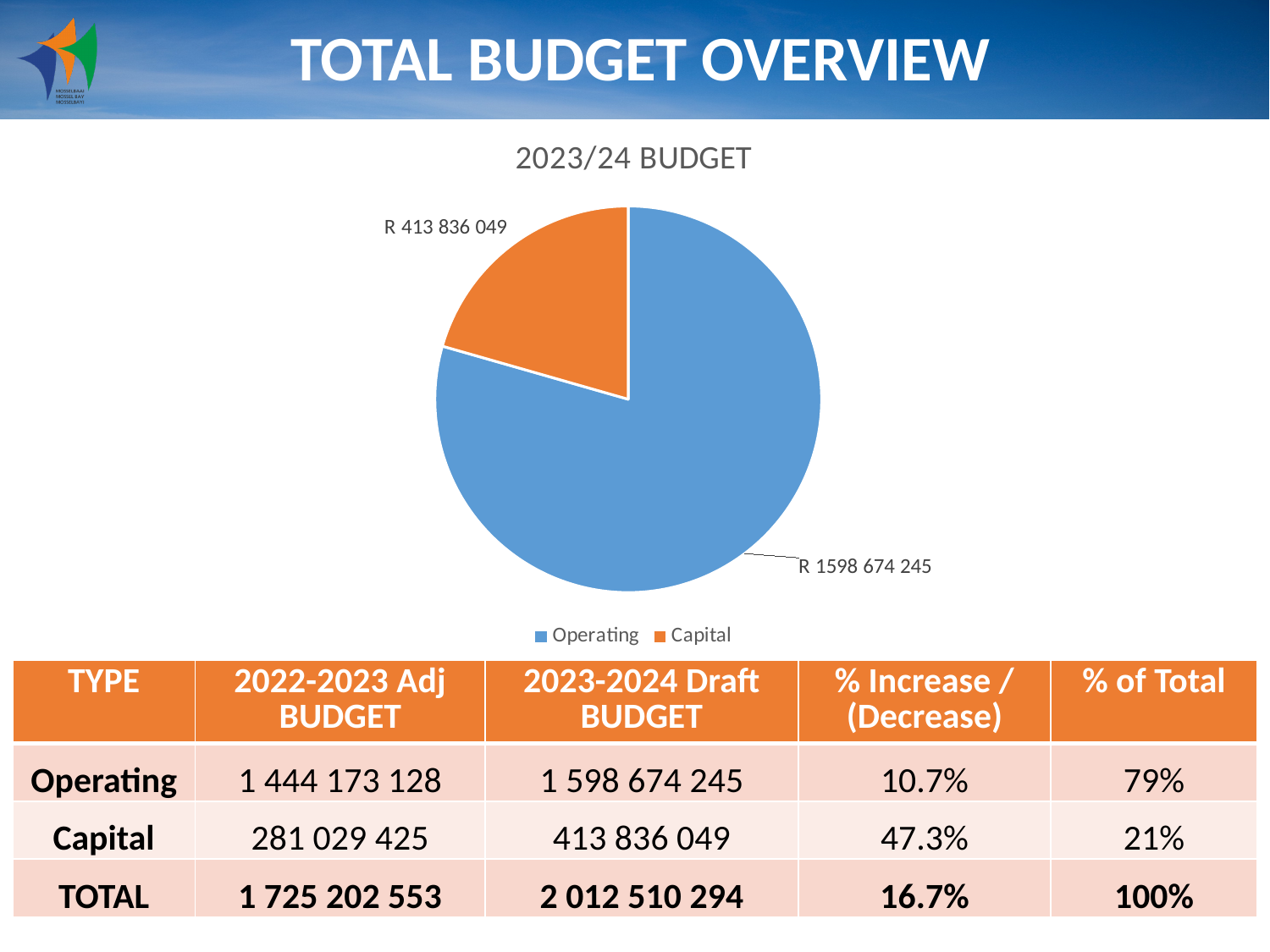
Which slice of the pie chart is the largest? Operating What colour is the Capital slice in the pie chart? Orange Which slice of the pie chart is the smallest? Capital What is the difference between the Operating and Capital values in the pie chart? R 1 184 838 196 Which is larger in the pie chart, Operating or Capital? Operating What type of chart is shown on the slide? Pie chart What is the total of the two slices in the pie chart? R 2 012 510 294 How many entries does the chart legend list? 2 What is the value of the Operating slice in the pie chart? R 1598 674 245 What is the value of the Capital slice in the pie chart? R 413 836 049 How many slices does the pie chart have? 2 What is the title of the chart? 2023/24 BUDGET